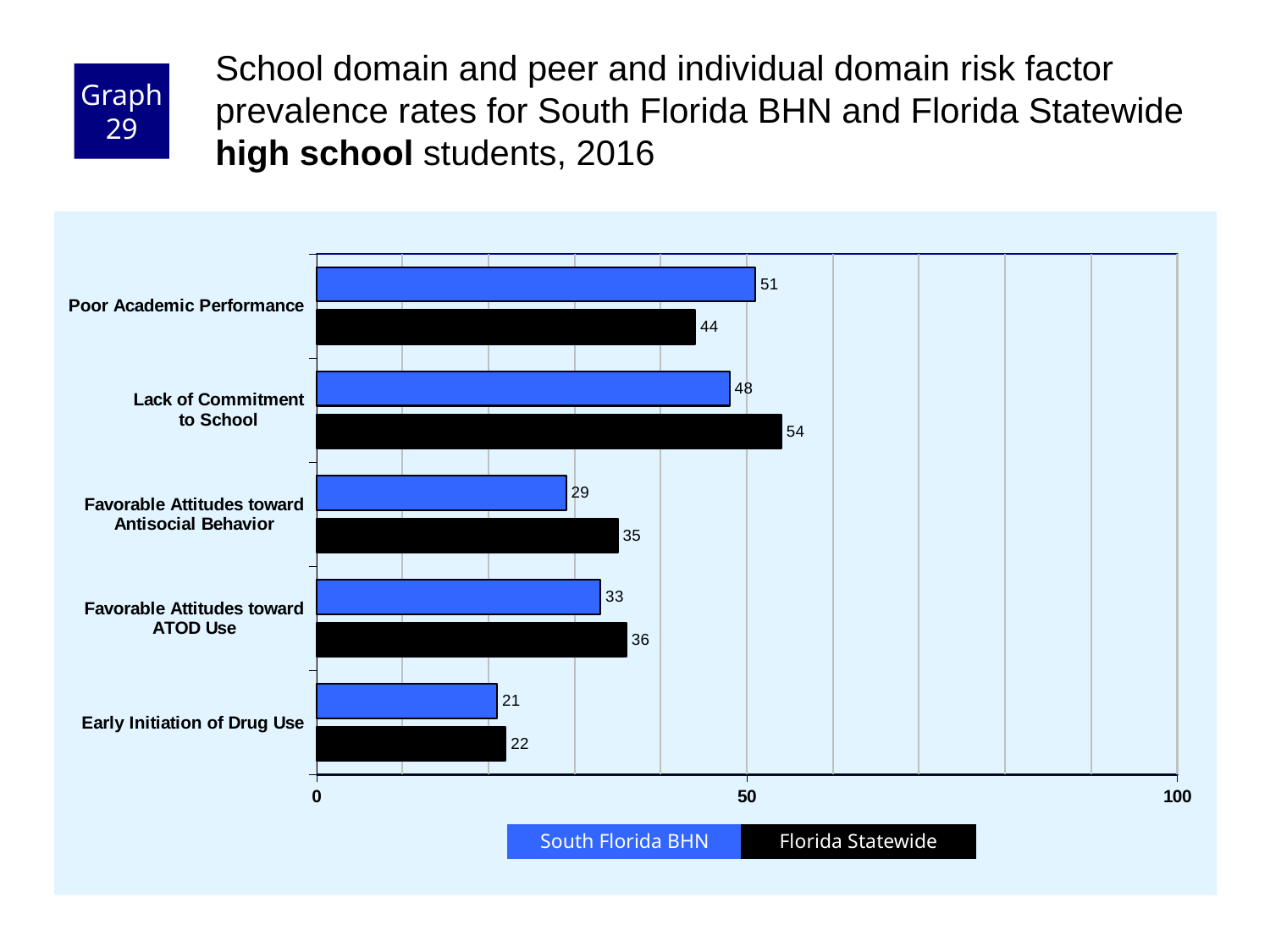
What colour are the Florida Statewide bars? black What is the South Florida BHN value for Early Initiation of Drug Use? 21 Is the Florida Statewide value for Favorable Attitudes toward ATOD Use greater or less than 50? less How many risk factor categories are shown in the chart? 5 Which risk factor has the lowest South Florida BHN value? Early Initiation of Drug Use Which risk factor has the highest Florida Statewide value? Lack of Commitment to School How many series does the legend list? 2 What kind of chart is shown on the slide? bar chart What is the difference between the Florida Statewide and South Florida BHN values for Favorable Attitudes toward Antisocial Behavior? 6 What is the Florida Statewide value for Lack of Commitment to School? 54 What is the South Florida BHN value for Poor Academic Performance? 51 For Poor Academic Performance, which is larger: South Florida BHN or Florida Statewide? South Florida BHN